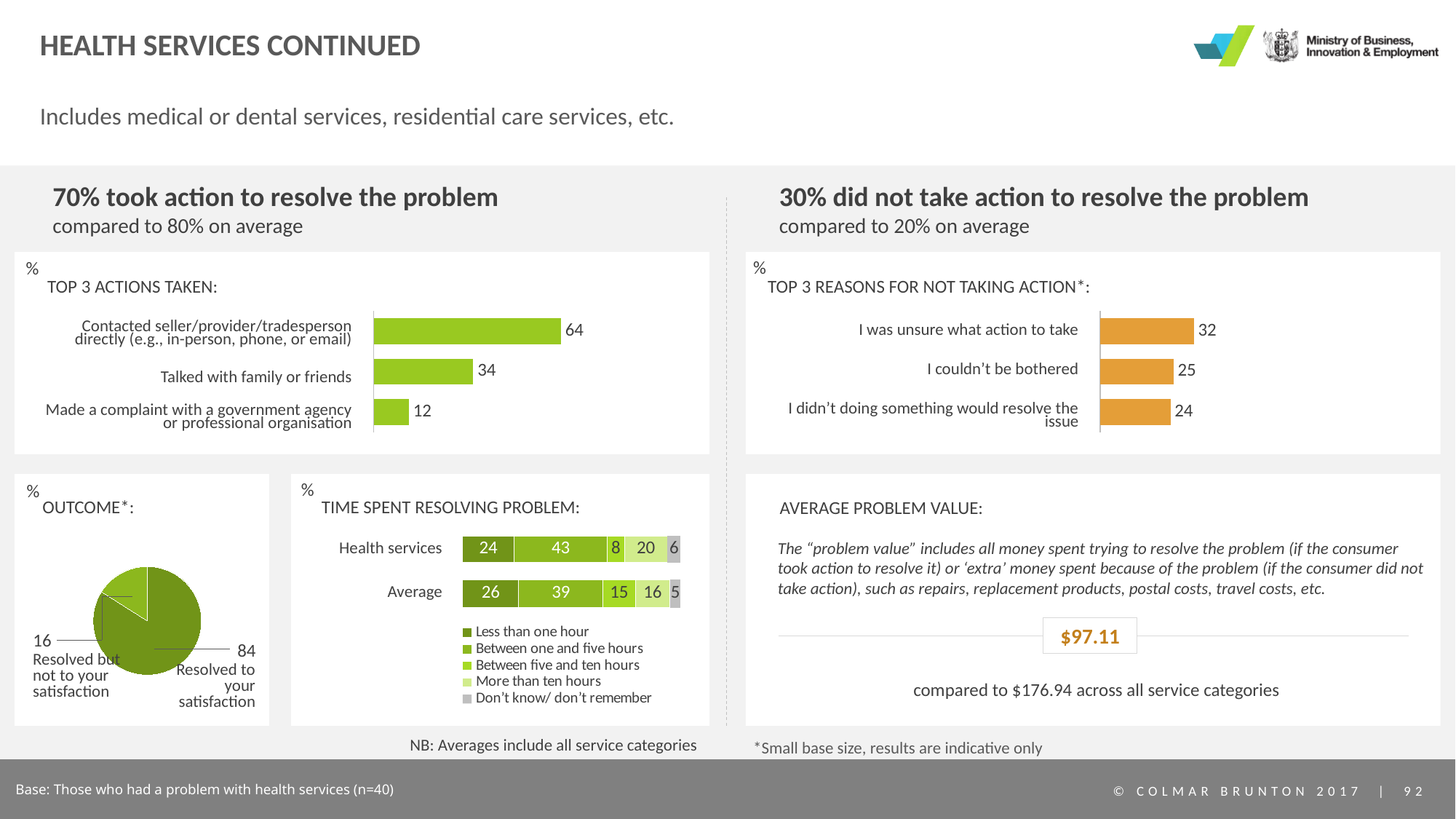
In the 'Top 3 reasons for not taking action' chart, which reason has the lowest value? I didn't doing something would resolve the issue In the 'Top 3 actions taken' chart, what is the value for 'Talked with family or friends'? 34 In the 'Time spent resolving problem' chart, how many categories does the legend list? 5 In the 'Outcome' pie chart, what share is 'Resolved to your satisfaction'? 84 In the 'Time spent resolving problem' chart, what is the 'Between one and five hours' value for Health services? 43 In the 'Time spent resolving problem' chart, what is the total of the Health services bar? 101 In the 'Time spent resolving problem' chart, which is larger for 'Between five and ten hours': Health services or Average? Average In the 'Top 3 reasons for not taking action' chart, how many reasons are shown? 3 In the 'Top 3 actions taken' chart, which action has the highest value? Contacted seller/provider/tradesperson directly (e.g., in-person, phone, or email) In the 'Top 3 actions taken' chart, what is the difference between the values for contacting the seller directly and making a complaint with a government agency or professional organisation? 52 What kind of chart is the 'Outcome' chart? Pie chart In the 'Top 3 reasons for not taking action' chart, what is the value for 'I couldn't be bothered'? 25